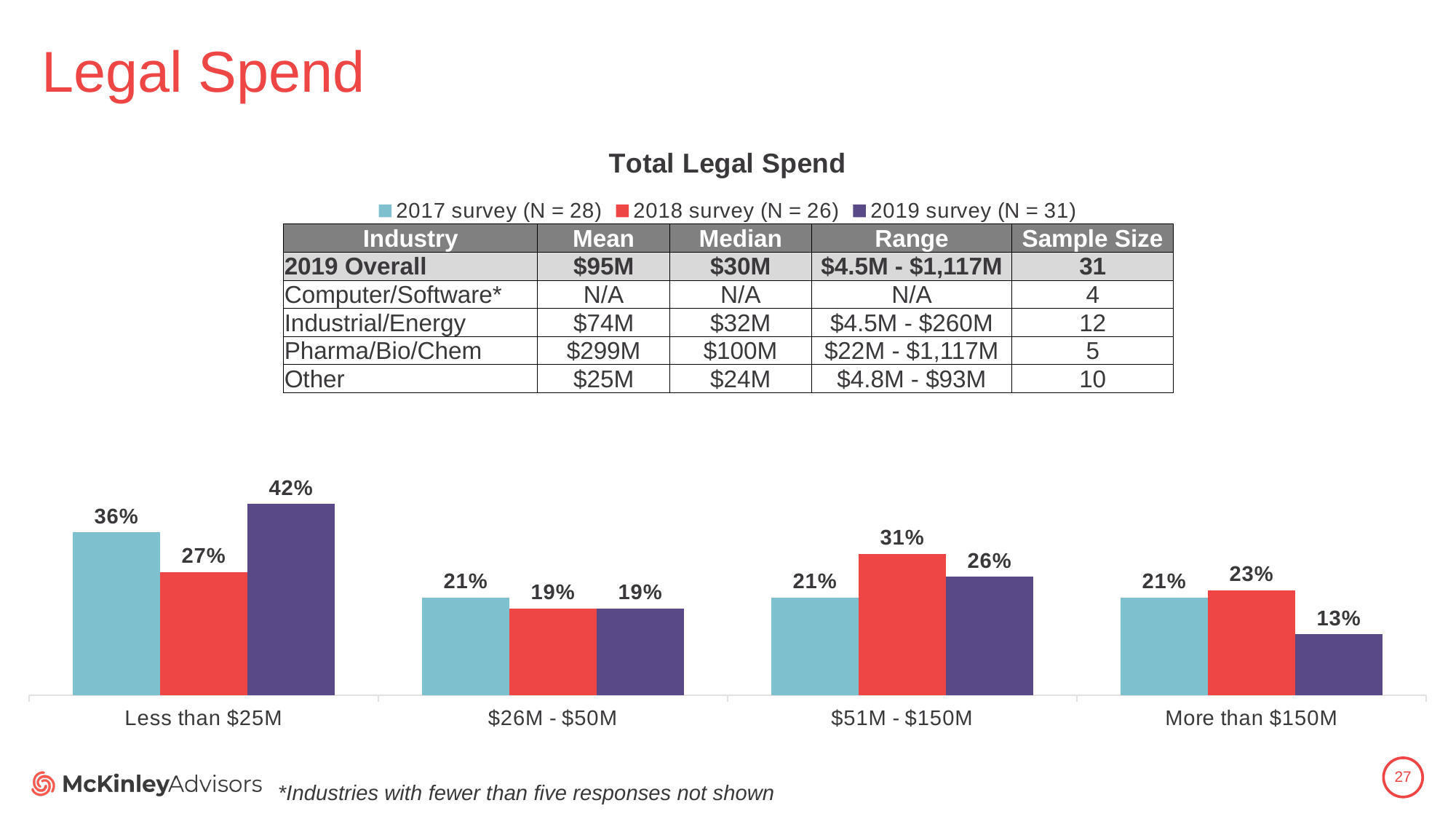
What is the difference between the 2019 survey and 2017 survey values in the Less than $25M category? 6% In the $51M - $150M category, which survey has the larger value: 2017 or 2018? 2018 survey What is the difference between the 2018 survey and 2019 survey values in the More than $150M category? 10% How many spend categories are shown on the x axis of the chart? 4 Which spend category has the lowest value for the 2019 survey? More than $150M What type of chart is used to show the Total Legal Spend distribution? Bar chart What percentage of respondents in the 2019 survey reported total legal spend of less than $25M? 42% What is the sample size for the 2019 survey according to the legend? 31 What is the value for the 2017 survey in the More than $150M category? 21% What is the value for the 2018 survey in the $51M - $150M category? 31% How many series does the chart legend list? 3 Which spend category has the highest value for the 2019 survey? Less than $25M